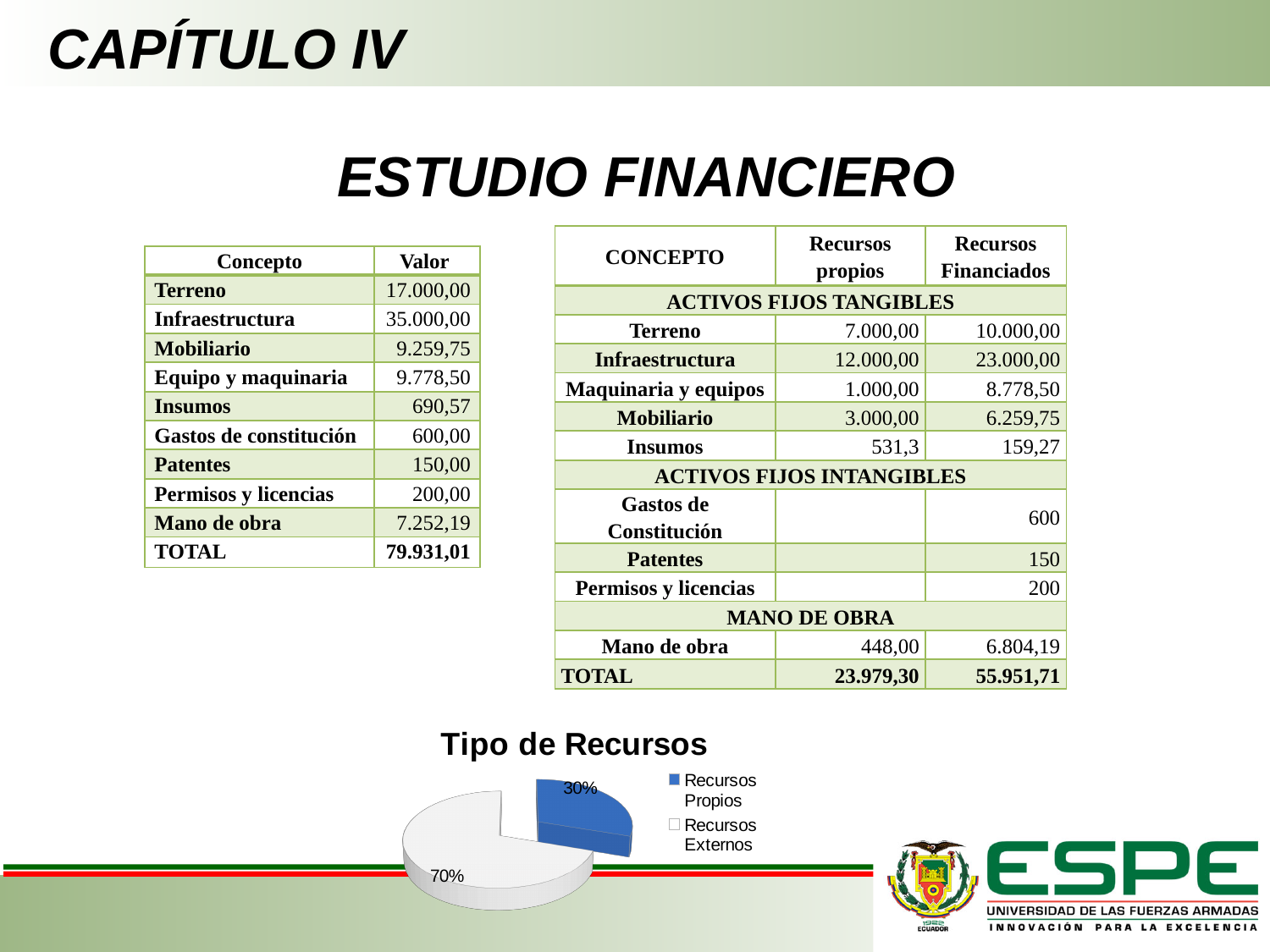
In the "Tipo de Recursos" pie chart, what share is labelled for Recursos Propios? 30% What colour is the Recursos Propios slice in the "Tipo de Recursos" pie chart? Blue Which slice of the "Tipo de Recursos" pie chart is the smallest? Recursos Propios How many slices does the "Tipo de Recursos" pie chart have? 2 In the "Tipo de Recursos" pie chart, what share is labelled for Recursos Externos? 70% In the "Tipo de Recursos" pie chart, what is the difference in percentage points between Recursos Externos and Recursos Propios? 40 percentage points What type of chart is shown under the title "Tipo de Recursos"? Pie chart How many entries does the legend of the "Tipo de Recursos" chart list? 2 Which slice of the "Tipo de Recursos" pie chart is the largest? Recursos Externos What is the title of the chart on the slide? Tipo de Recursos In the "Tipo de Recursos" pie chart, which is larger: Recursos Propios or Recursos Externos? Recursos Externos